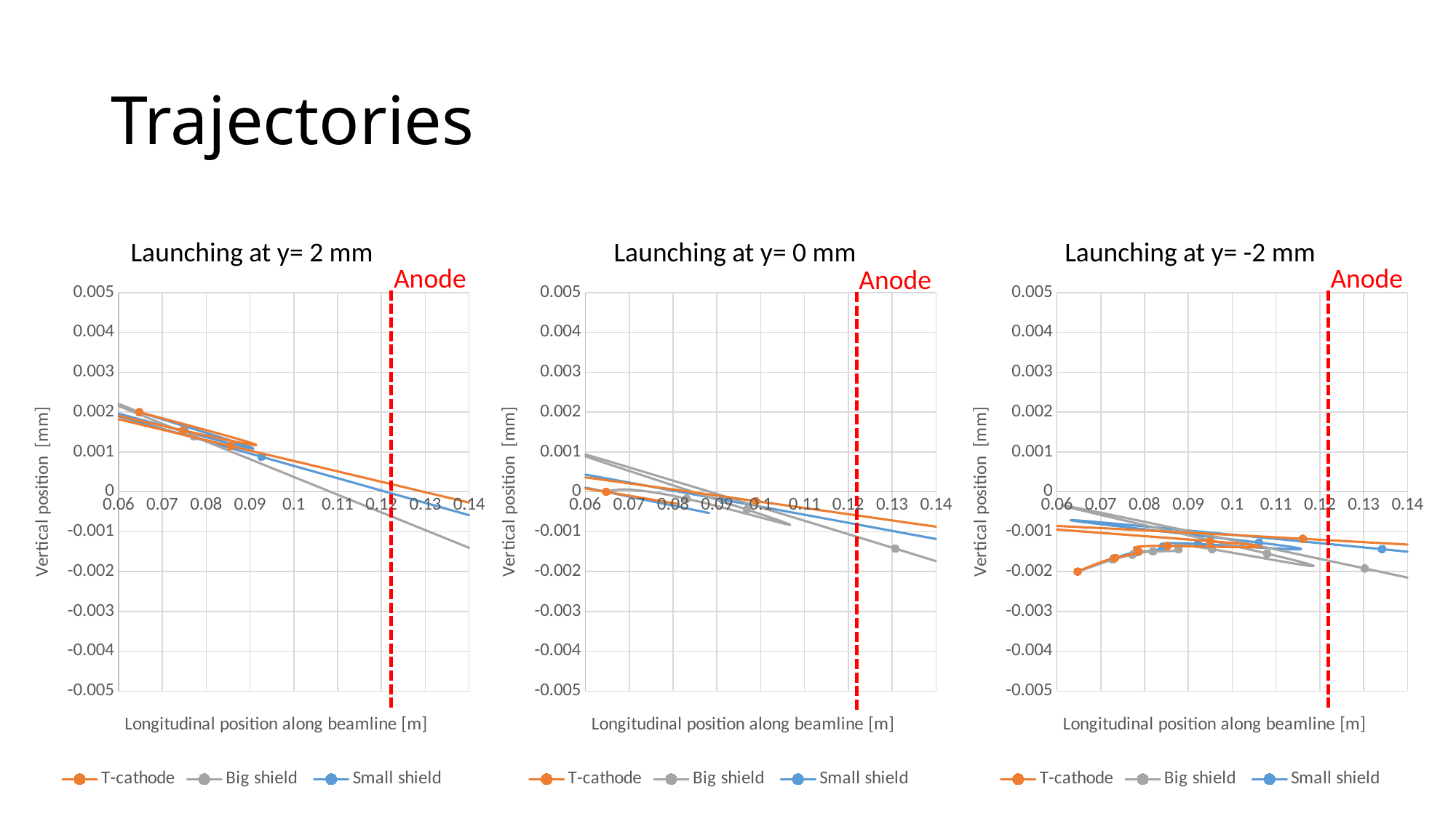
In the chart titled "Launching at y= 0 mm", is the Big shield value at a longitudinal position of 0.14 greater or less than -0.001? less In the chart titled "Launching at y= -2 mm", does the T-cathode trajectory rise or fall between longitudinal positions 0.06 and 0.09? rise In the chart titled "Launching at y= 2 mm", do the trajectories rise or fall as the longitudinal position increases from 0.06 to 0.14? fall In the chart titled "Launching at y= 2 mm", which series has the lowest value at a longitudinal position of 0.14? Big shield In the chart titled "Launching at y= 0 mm", how many series does the legend list? 3 In the chart titled "Launching at y= -2 mm", what are the three series named in the legend? T-cathode, Big shield, Small shield In the chart titled "Launching at y= -2 mm", is the Small shield value at a longitudinal position of 0.14 greater or less than -0.002? greater In the chart titled "Launching at y= 0 mm", what does the red dashed vertical line represent? Anode In the chart titled "Launching at y= 2 mm", what kind of chart is shown? line chart In the chart titled "Launching at y= 2 mm", is the Big shield value at a longitudinal position of 0.14 greater or less than -0.001? less